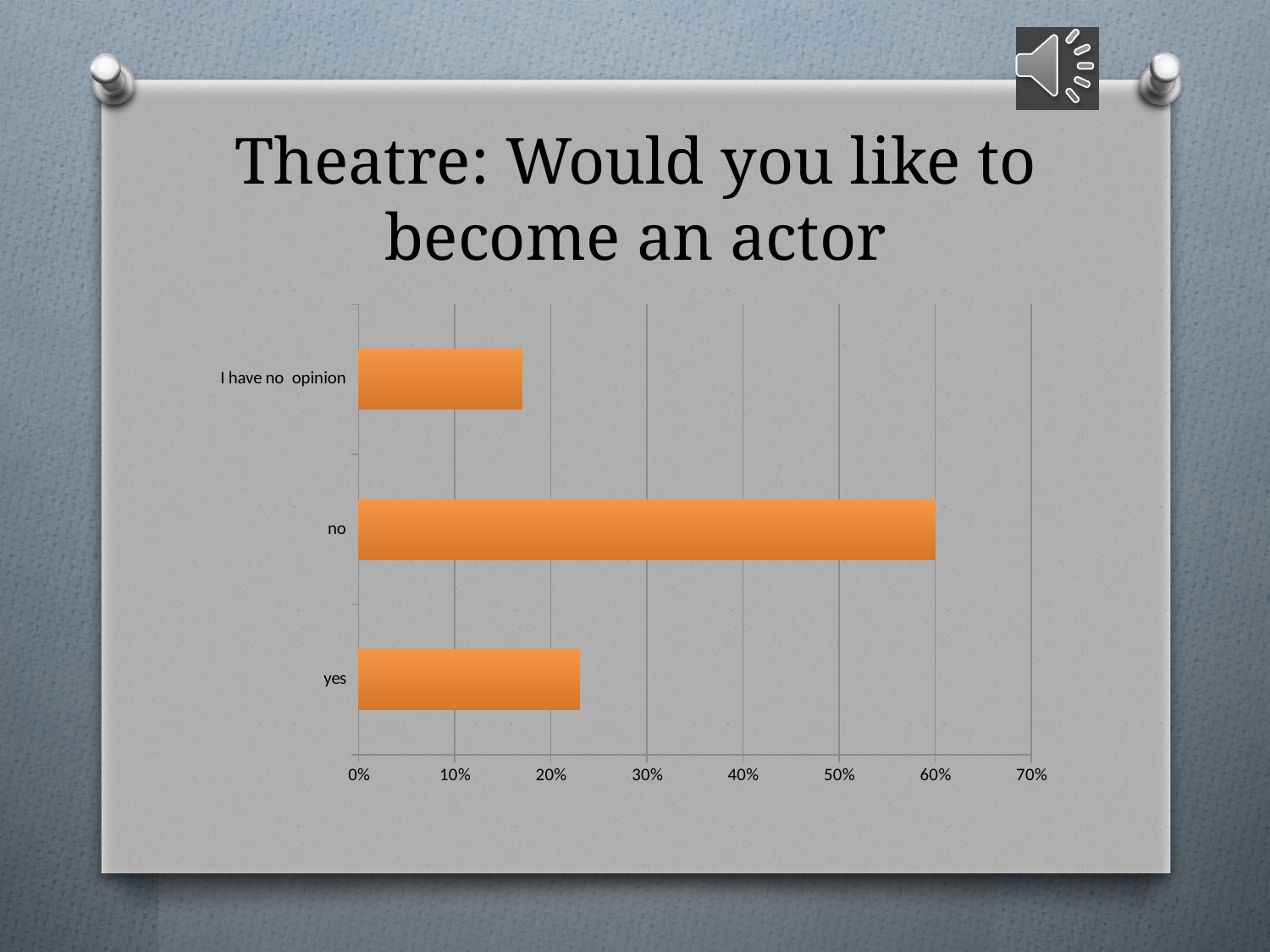
What is the value for "no"? 60% Which is larger, the value for "yes" or the value for "I have no opinion"? yes Is the value for "I have no opinion" greater or less than 10%? greater What is the highest value shown on the horizontal axis? 70% How many categories are shown in the chart? 3 What kind of chart is shown on the slide? bar chart Which category has the lowest value? I have no opinion Is the value for "I have no opinion" greater or less than 20%? less What is the title of the slide containing the chart? Theatre: Would you like to become an actor Which category has the highest value? no Is the value for "yes" greater or less than 20%? greater